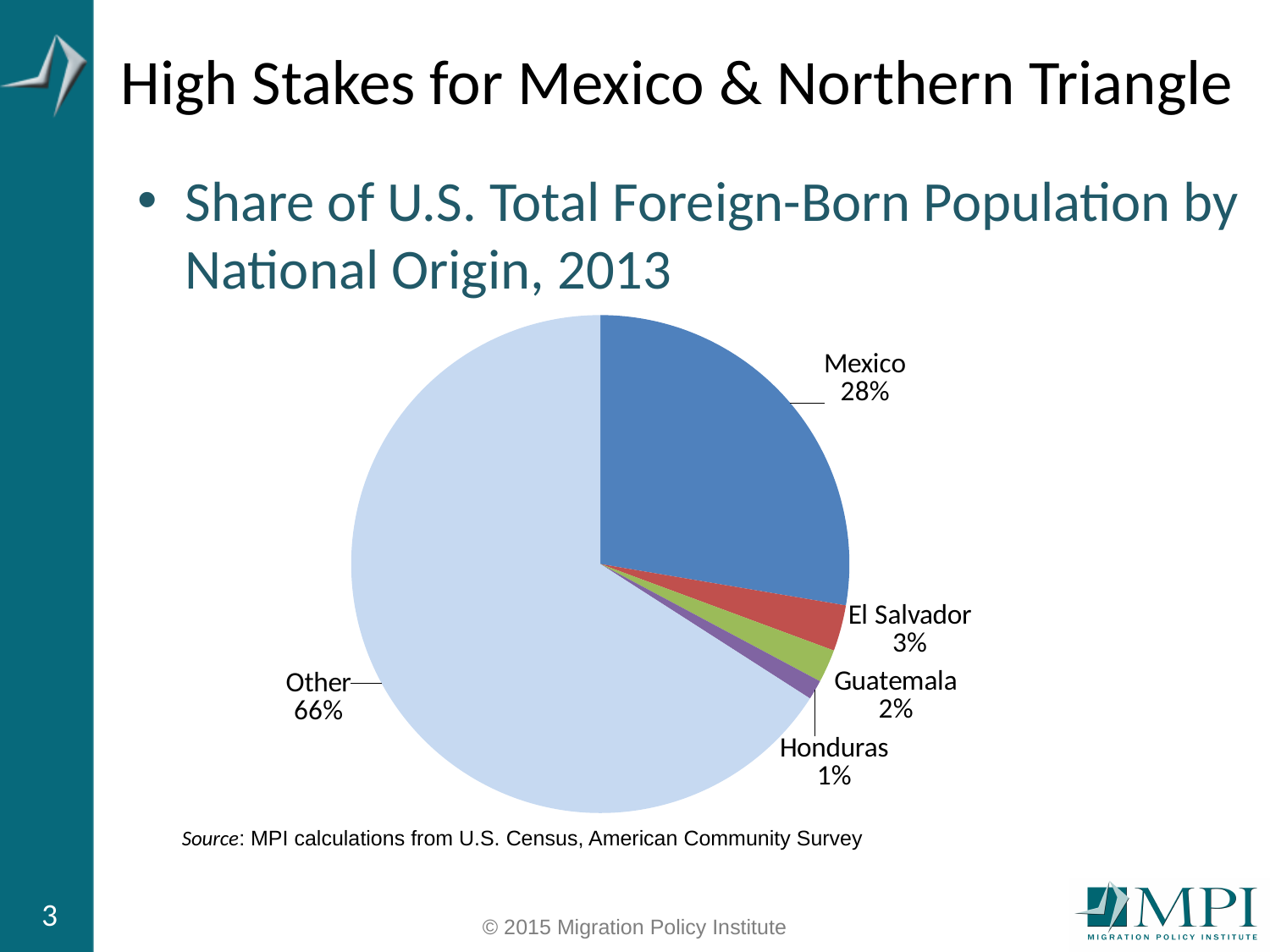
What is the difference in share between Mexico and El Salvador? 25% What share of the U.S. foreign-born population is from El Salvador? 3% What is the source cited below the chart? MPI calculations from U.S. Census, American Community Survey How many slices does the pie chart have? 5 What share of the U.S. foreign-born population is from Guatemala? 2% Which has a larger share, Guatemala or El Salvador? El Salvador Which slice of the pie is the largest? Other Which slice of the pie is the smallest? Honduras What share of the U.S. foreign-born population is from Honduras? 1% What kind of chart is shown on the slide? pie chart What share of the U.S. foreign-born population is from Mexico? 28% What share of the pie is labelled Other? 66%